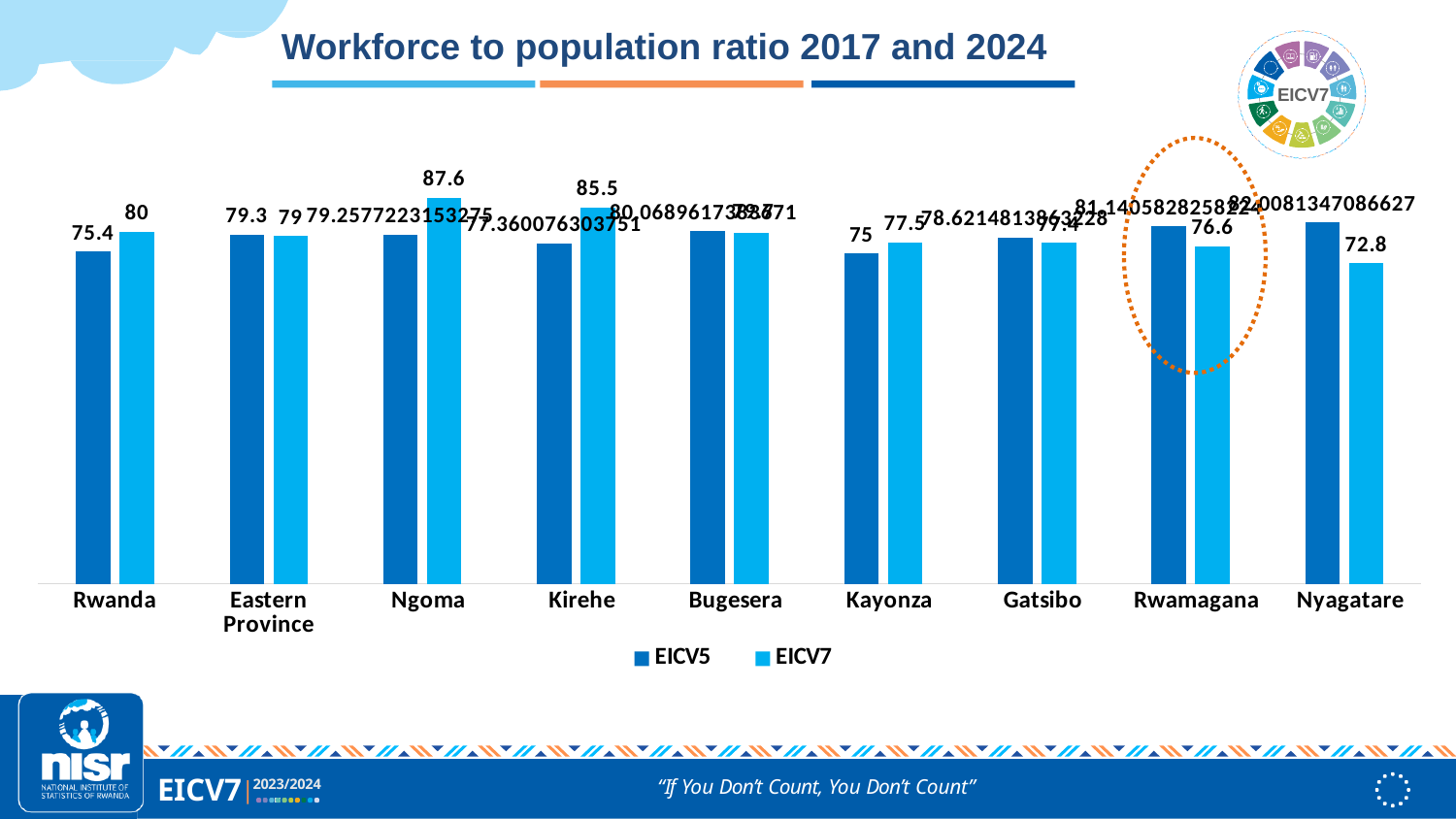
What is the EICV7 value for Nyagatare? 72.8 How many series does the legend list? 2 What is the difference between the EICV7 and EICV5 values for Rwanda? 4.6 Which district has the lowest EICV7 value? Nyagatare What is the EICV5 value for Kayonza? 75 What is the EICV7 value for Rwanda? 80 What is the EICV5 value for Rwanda? 75.4 What is the difference between the EICV7 values for Ngoma and Kirehe? 2.1 Which district has the highest EICV7 value? Ngoma For Rwamagana, which is larger, the EICV5 value or the EICV7 value? EICV5 What is the EICV7 value for Ngoma? 87.6 How many categories are shown on the x axis? 9